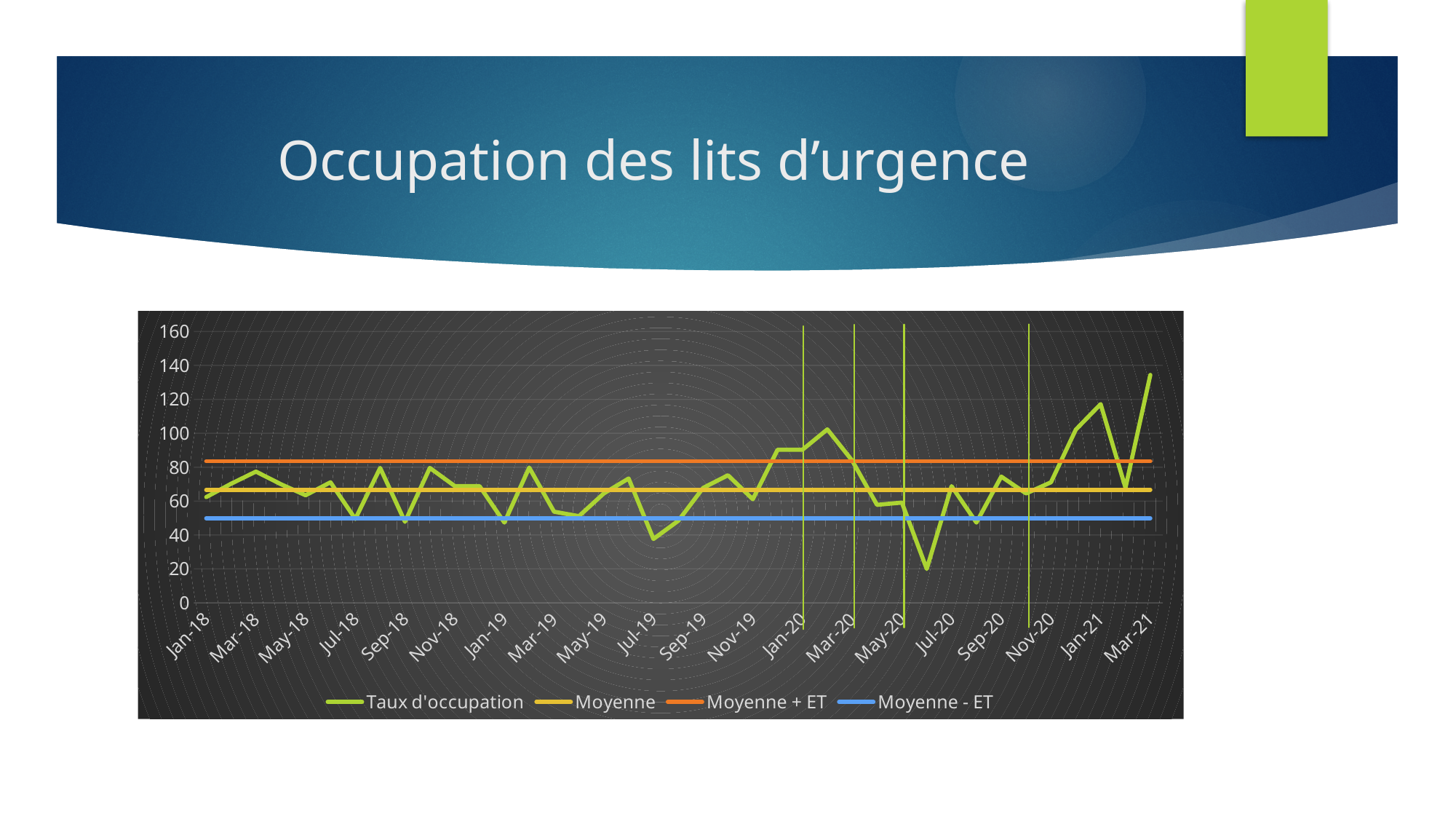
Which month has the highest value of Taux d'occupation? Mar-21 Is the value of Taux d'occupation for Jul-19 greater or less than 60? less How many series does the legend list? 4 Is the Moyenne line greater or less than 60? greater Is the lowest value of Taux d'occupation greater or less than 40? less What kind of chart is shown on the slide? line chart What is the title of the slide containing the chart? Occupation des lits d'urgence Which is larger, the Taux d'occupation for Mar-21 or for Jan-18? Mar-21 Which series is drawn in orange in the chart? Moyenne + ET